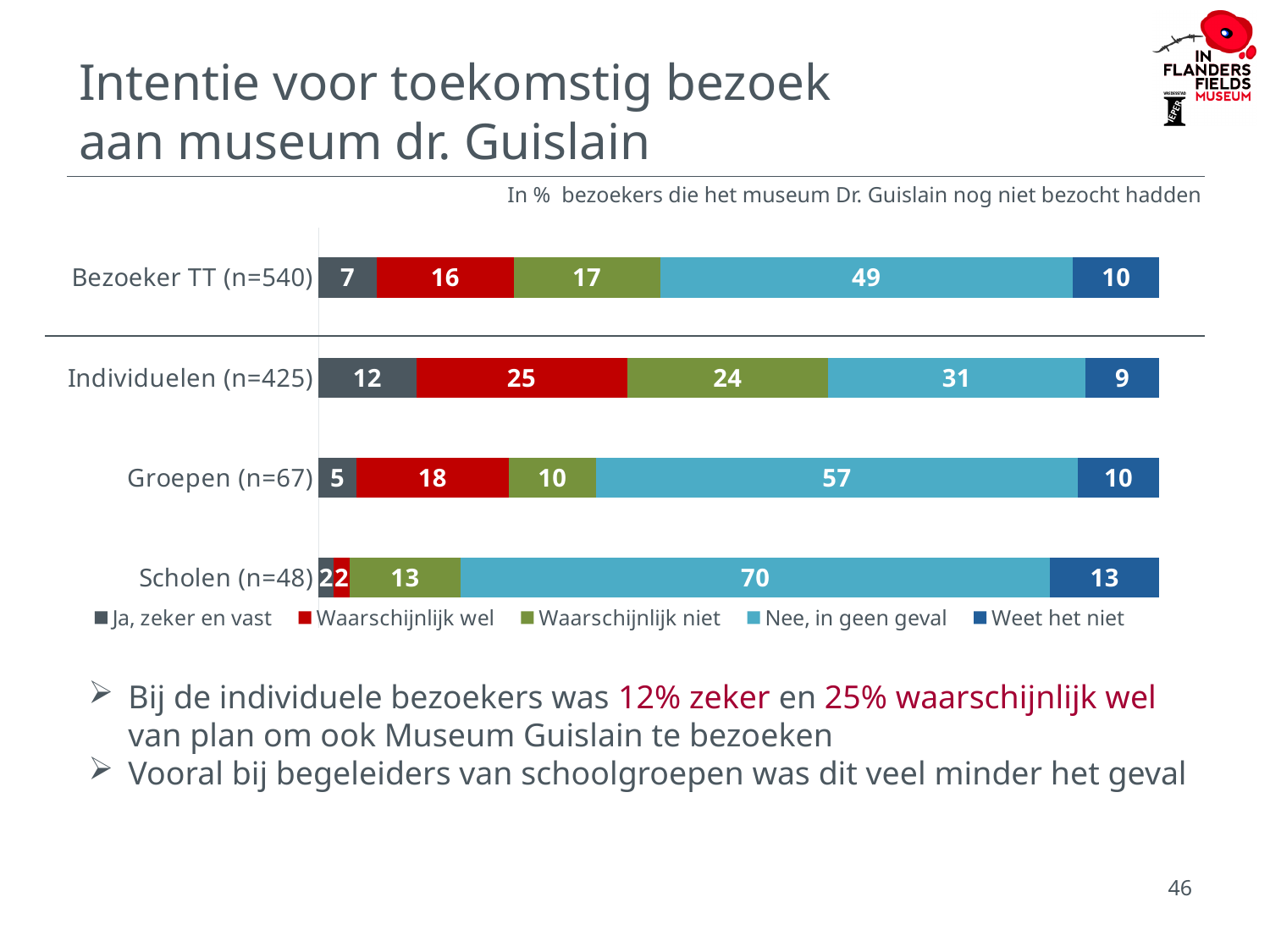
What is the value for 'Waarschijnlijk wel' for Individuelen (n=425)? 25 Which is larger: the 'Waarschijnlijk niet' value for Bezoeker TT (n=540) or for Groepen (n=67)? Bezoeker TT (n=540) Which category has the lowest value for 'Ja, zeker en vast'? Scholen (n=48) What is the difference between the 'Nee, in geen geval' values for Groepen (n=67) and Individuelen (n=425)? 26 What is the total of the stacked bar for Groepen (n=67)? 100 How many series does the legend list? 5 Which category has the highest value for 'Nee, in geen geval'? Scholen (n=48) How many categories (visitor groups) are shown in the chart? 4 What is the value for 'Ja, zeker en vast' for Groepen (n=67)? 5 What is the value for 'Nee, in geen geval' for Scholen (n=48)? 70 What is the value for 'Weet het niet' for Bezoeker TT (n=540)? 10 What kind of chart is shown on the slide? Stacked bar chart